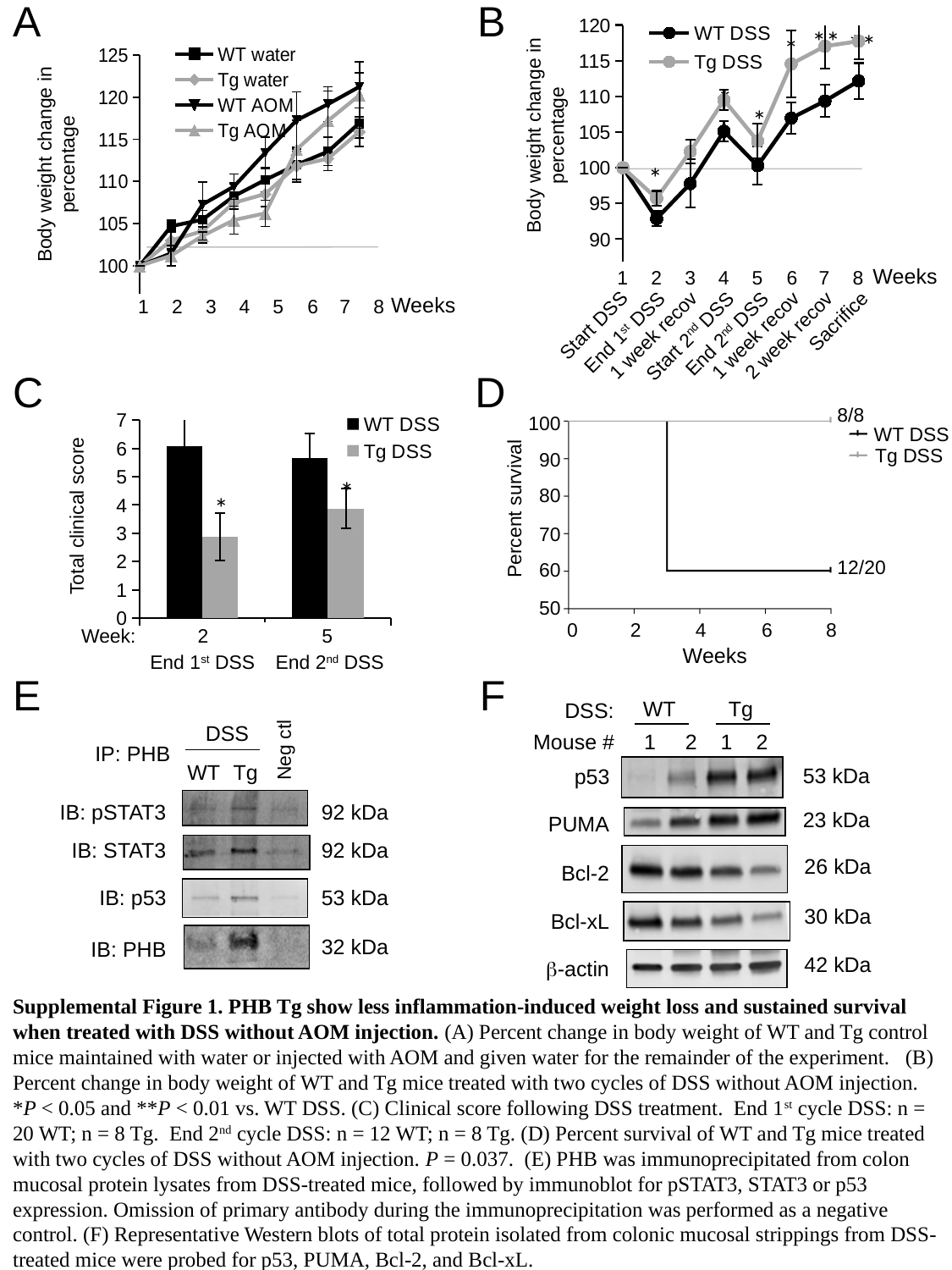
In chart C (Total clinical score), which bar is the lowest? Tg DSS at week 2 In chart C (Total clinical score), what kind of chart is shown? bar chart In chart D (Percent survival), what fraction label is shown at the end of the WT DSS line? 12/20 In chart A (top left), how many series does the legend list? 4 In chart D (Percent survival), what percent survival does the WT DSS line end at? 60 In chart C (Total clinical score), which series has the larger bar at week 2, WT DSS or Tg DSS? WT DSS In chart C (Total clinical score), how many week categories are shown on the x axis? 2 In chart C (Total clinical score), is the value for WT DSS at week 2 greater or less than 5? greater In chart D (Percent survival), what fraction label is shown at the end of the Tg DSS line? 8/8 In chart B (top right), is the value for WT DSS at week 2 greater or less than 95? less In chart B (top right), how many series does the legend list? 2 In chart A (top left), does the WT AOM series rise or fall from week 1 to week 8? rise